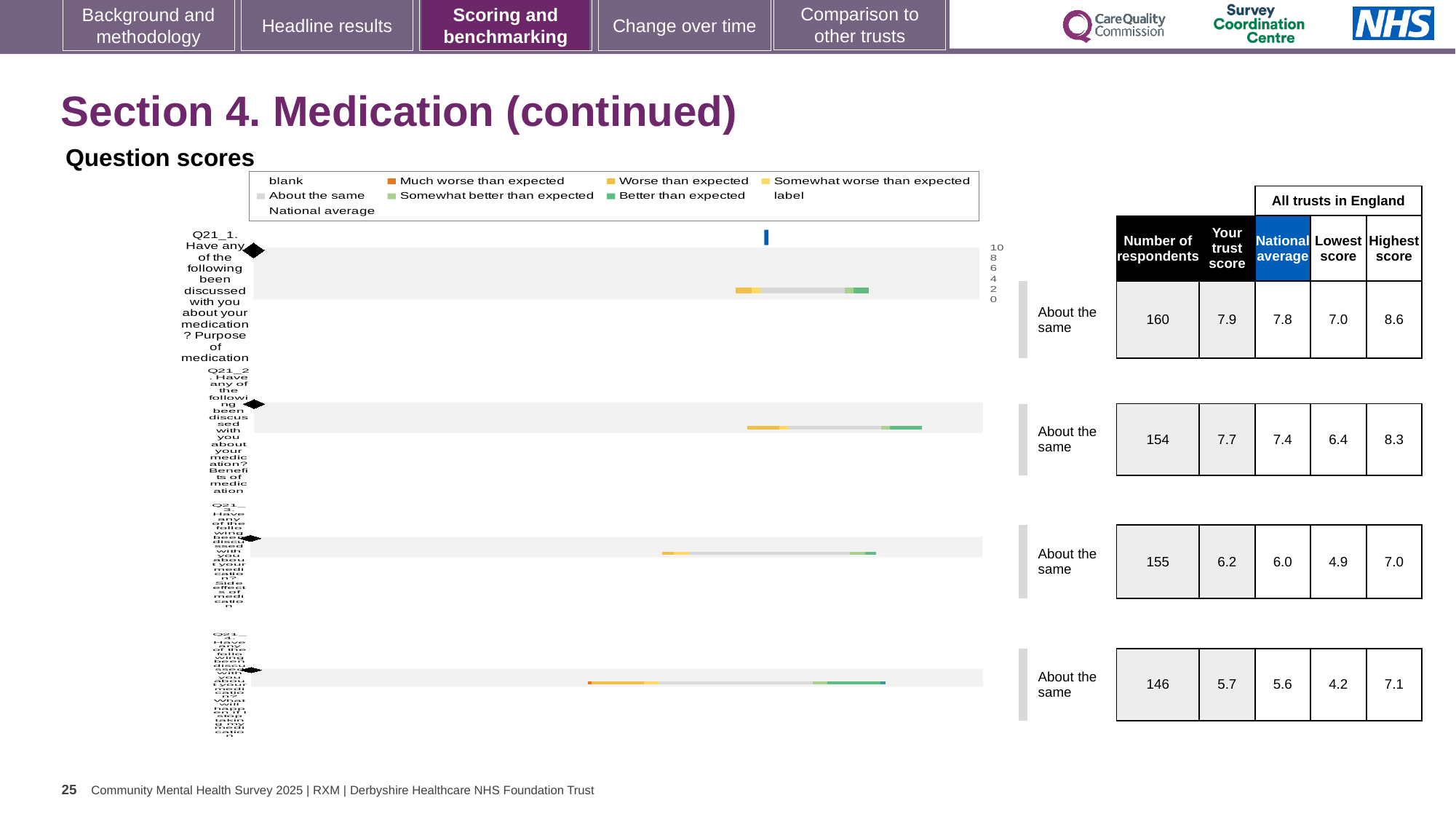
Which of the four questions has the highest trust score? Q21_1 What is the trust score for Q21_1 (purpose of medication)? 7.9 Which legend entry is shown in dark orange? Much worse than expected What kind of chart is used for the question scores on this slide? bar chart Which of the four questions has the lowest trust score? Q21_4 What is the highest tick value shown on the chart's score axis? 10 Is the trust score for Q21_4 greater or less than 6? less What is the national average for Q21_4 (what might happen if you stop taking medication)? 5.6 What is the difference between the trust score and the national average for Q21_2 (benefits of medication)? 0.3 Is the trust score for Q21_3 (side effects of medication) higher or lower than the national average? higher How many entries does the chart legend list? 9 How many question rows (Q21_1 to Q21_4) are charted on this slide? 4